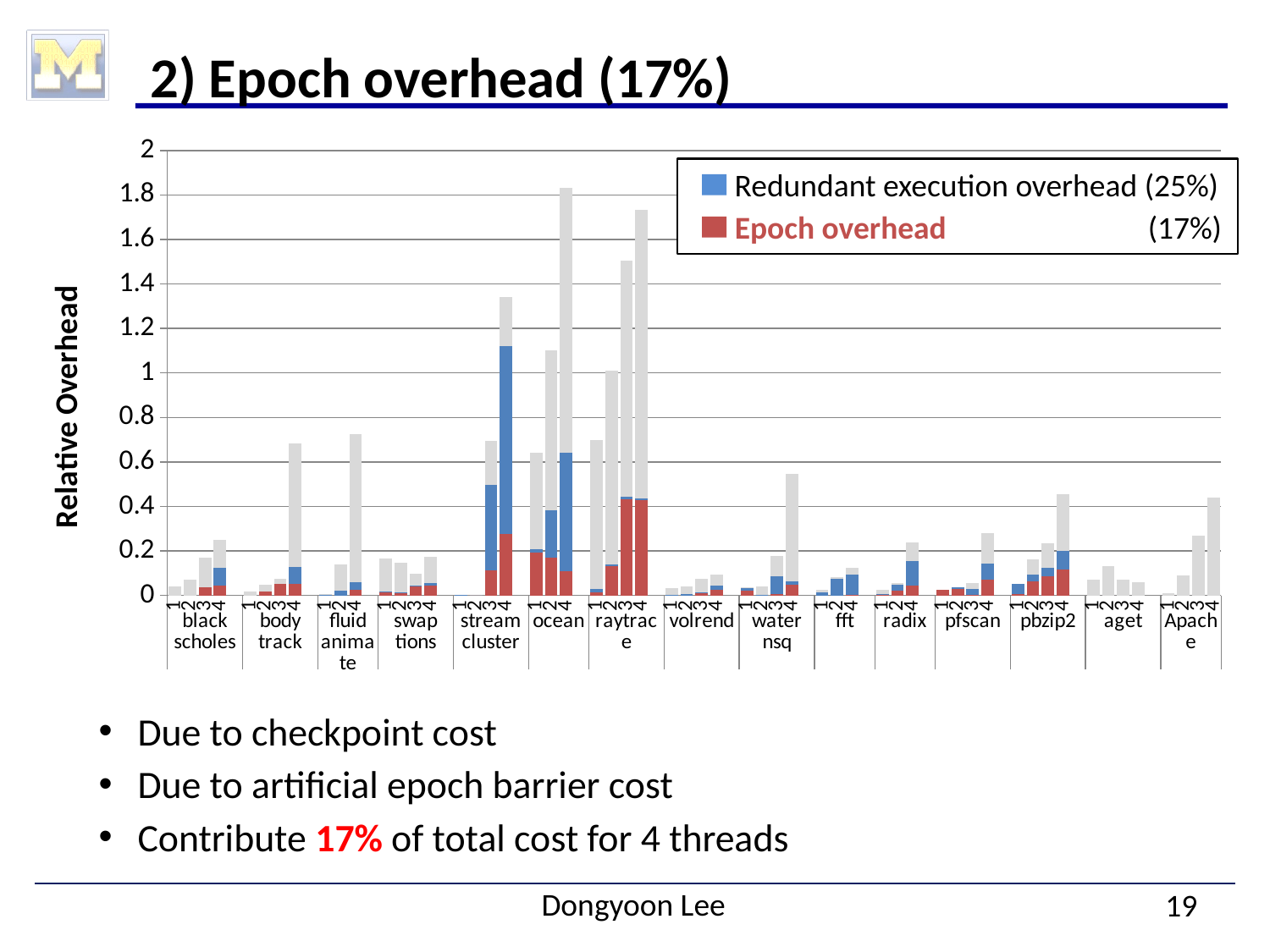
Which benchmark has the tallest blue (Redundant execution overhead) segment? streamcluster What percentage is shown next to the legend entry 'Redundant execution overhead'? 25% Is the tallest bar for ocean greater or less than 1.6? greater Is the tallest bar for streamcluster greater or less than 1.2? greater Is the top of the blue segment for streamcluster with 4 threads greater or less than 1? greater Which benchmark has the tallest bar in the chart? ocean What kind of chart is shown on the slide? stacked bar chart How many series does the chart legend list? 2 What is the label of the vertical axis of the chart? Relative Overhead How many benchmark groups are shown along the x axis of the chart? 15